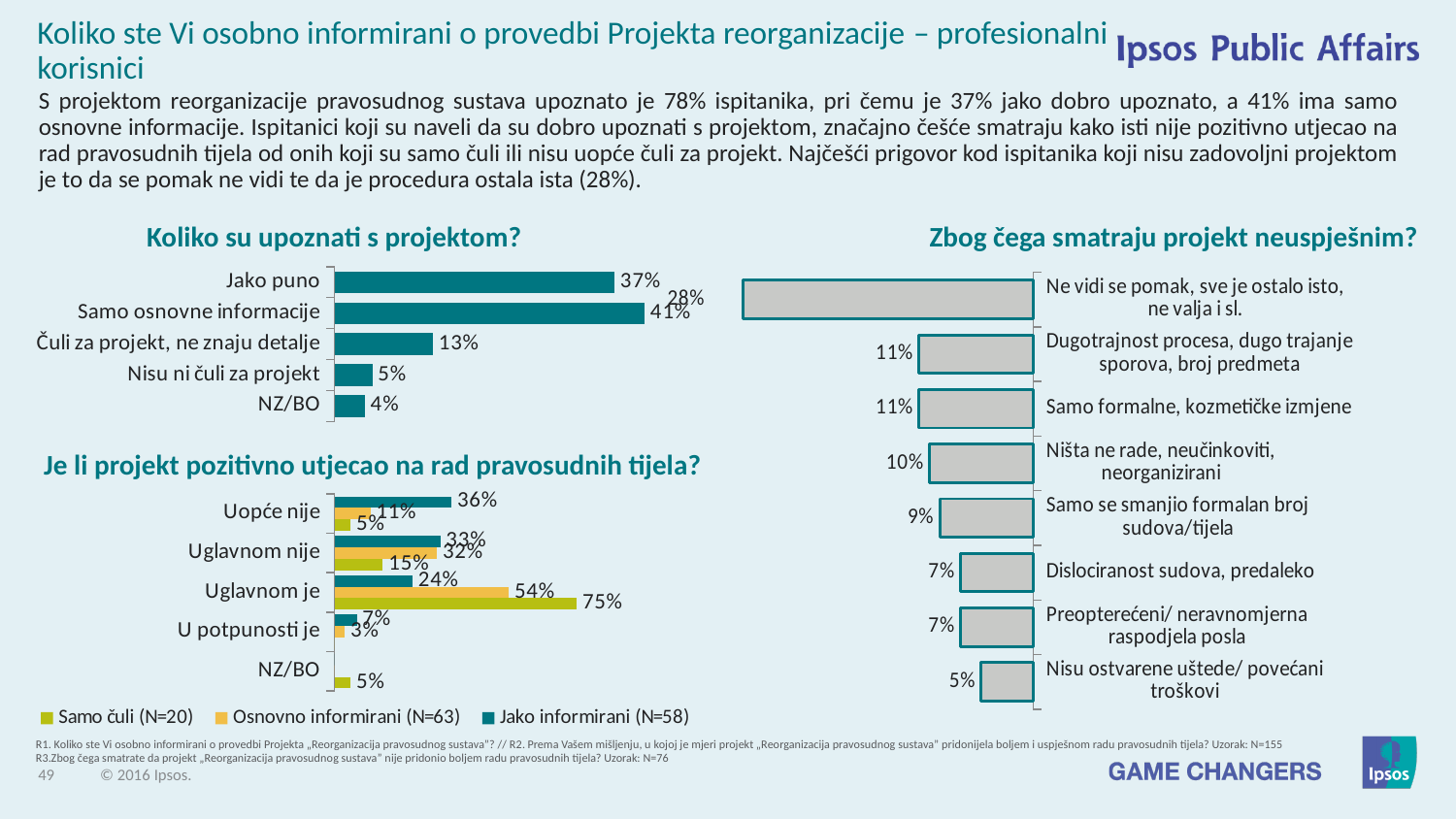
In the chart 'Zbog čega smatraju projekt neuspješnim?', which category has the lowest value? Nisu ostvarene uštede/ povećani troškovi In the chart 'Koliko su upoznati s projektom?', what is the value for 'Jako puno'? 37% In the chart 'Je li projekt pozitivno utjecao na rad pravosudnih tijela?', which series has the larger value for 'Uglavnom je': 'Osnovno informirani (N=63)' or 'Jako informirani (N=58)'? Osnovno informirani (N=63) What type of chart is 'Zbog čega smatraju projekt neuspješnim?'? Bar chart How many categories are shown in the chart 'Koliko su upoznati s projektom?'? 5 In the chart 'Koliko su upoznati s projektom?', what is the difference between 'Samo osnovne informacije' and 'Čuli za projekt, ne znaju detalje'? 28% In the chart 'Zbog čega smatraju projekt neuspješnim?', what is the value for 'Dislociranost sudova, predaleko'? 7% In the chart 'Koliko su upoznati s projektom?', which category has the lowest value? NZ/BO In the chart 'Je li projekt pozitivno utjecao na rad pravosudnih tijela?', what is the value for 'Uglavnom je' in the 'Samo čuli (N=20)' series? 75% In the chart 'Je li projekt pozitivno utjecao na rad pravosudnih tijela?', what is the value for 'Uopće nije' in the 'Jako informirani (N=58)' series? 36% In the chart 'Koliko su upoznati s projektom?', which category has the highest value? Samo osnovne informacije How many series does the legend list for the chart 'Je li projekt pozitivno utjecao na rad pravosudnih tijela?'? 3